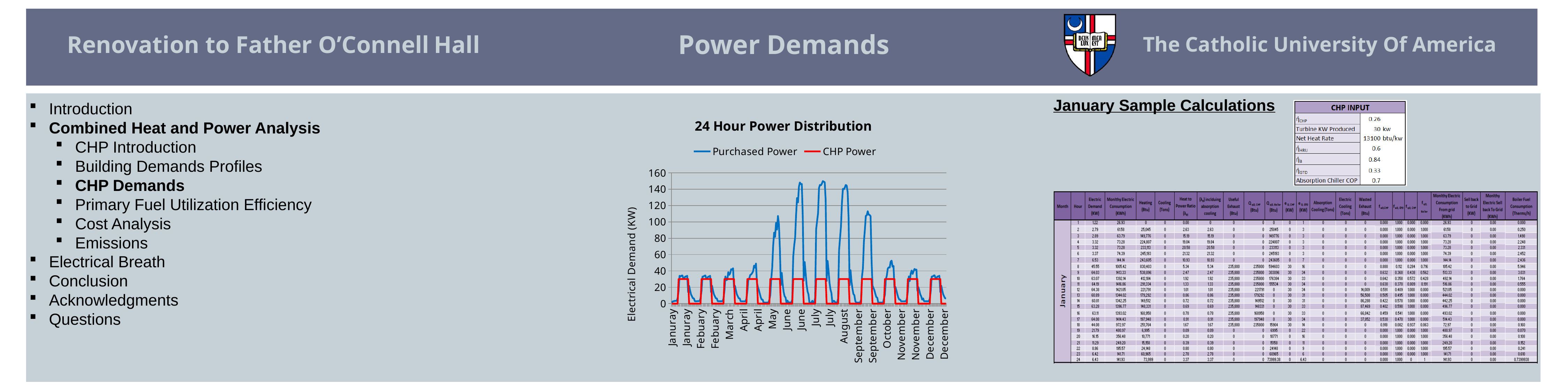
In the '24 Hour Power Distribution' chart, is the peak Purchased Power in July greater or less than 140? greater In the '24 Hour Power Distribution' chart, is the peak Purchased Power in March greater or less than 60? less How many distinct months are labeled on the x axis of the '24 Hour Power Distribution' chart? 12 In the '24 Hour Power Distribution' chart, is the highest value of CHP Power greater or less than 20? greater What is the title of the chart on the slide? 24 Hour Power Distribution What kind of chart is the '24 Hour Power Distribution' chart? line chart In the '24 Hour Power Distribution' chart, which series reaches higher values, Purchased Power or CHP Power? Purchased Power What is the highest value shown on the y axis of the '24 Hour Power Distribution' chart? 160 What is the y-axis title of the '24 Hour Power Distribution' chart? Electrical Demand (KW) How many series does the legend of the '24 Hour Power Distribution' chart list? 2